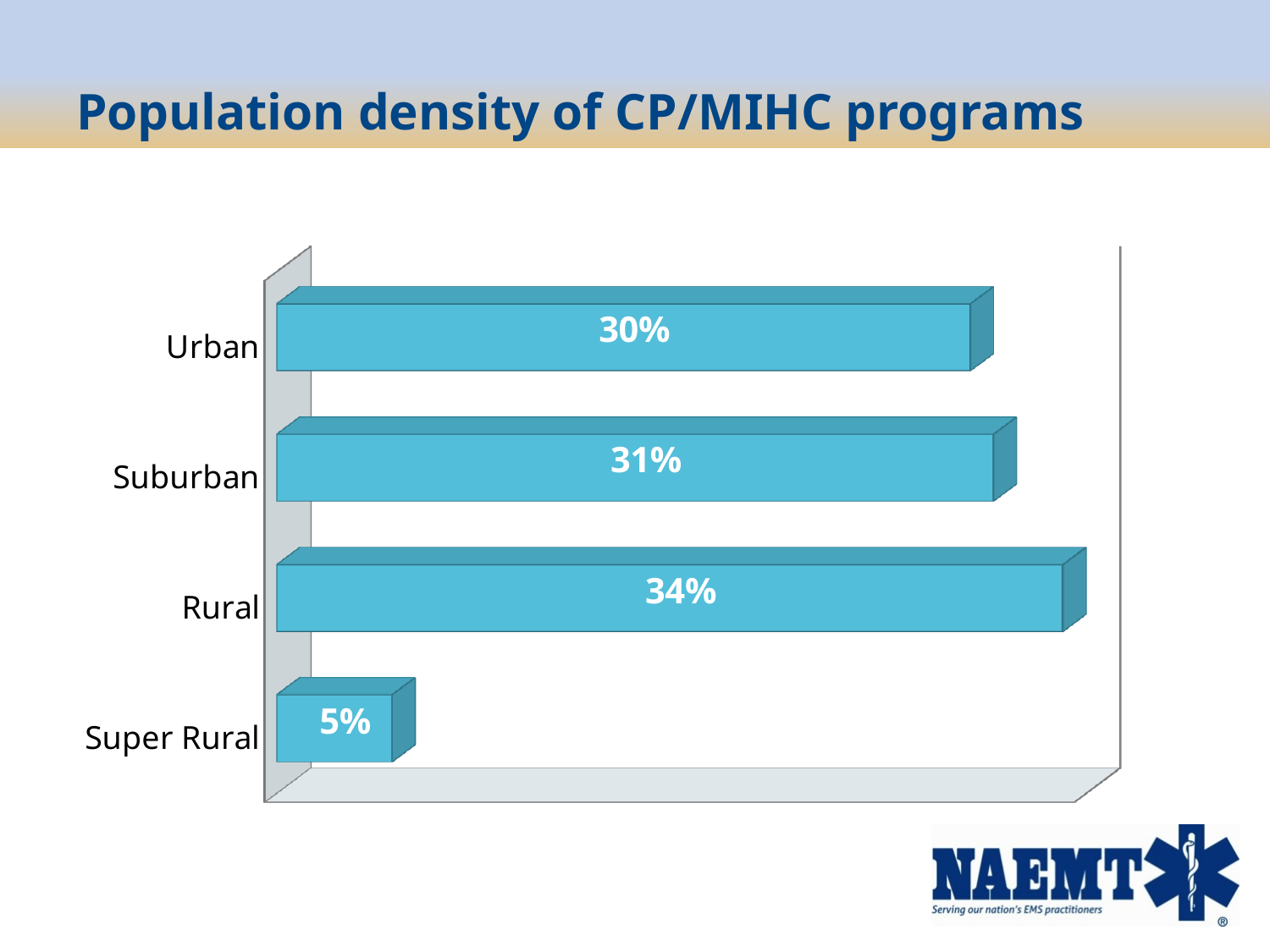
What is the difference between the values for Suburban and Urban? 1% Which category has the lowest value? Super Rural Which is larger, the value for Rural or the value for Urban? Rural What is the value for Rural? 34% What is the title of the slide? Population density of CP/MIHC programs Which category has the highest value? Rural What is the value for Urban? 30% What is the difference between the values for Rural and Super Rural? 29% What is the value for Super Rural? 5% What is the value for Suburban? 31% How many categories are shown in the chart? 4 What kind of chart is shown on the slide? Bar chart